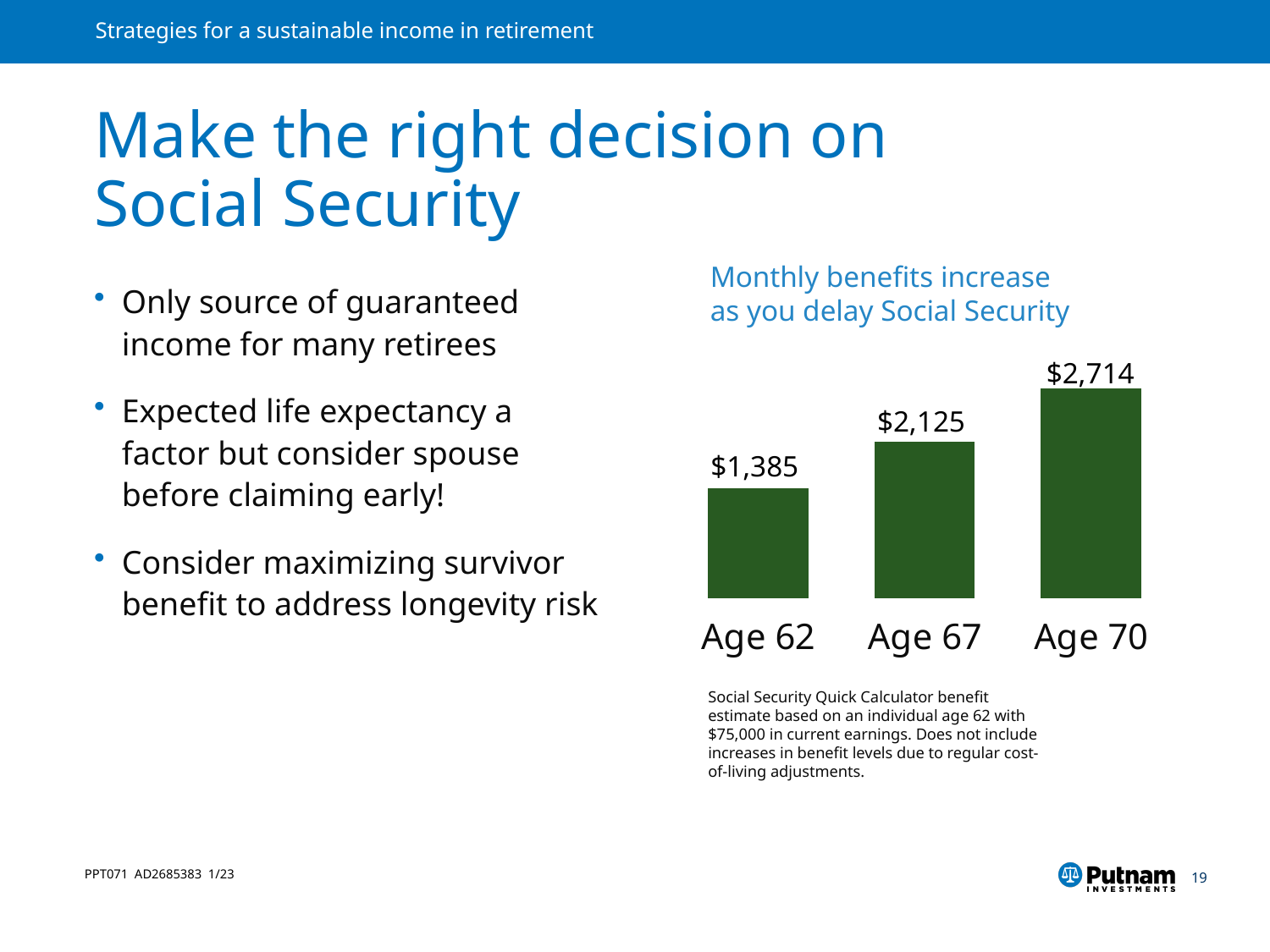
What kind of chart is shown on the slide? Bar chart Which age has the lowest monthly benefit? Age 62 What is the difference between the monthly benefit at Age 70 and at Age 62? $1,329 Which age has the highest monthly benefit? Age 70 What is the monthly benefit shown for Age 70? $2,714 How many age categories are shown in the chart? 3 What is the monthly benefit shown for Age 62? $1,385 Which is larger, the monthly benefit at Age 67 or at Age 70? Age 70 Do the monthly benefits rise or fall as age increases along the x axis? Rise What is the difference between the monthly benefit at Age 67 and at Age 62? $740 What is the monthly benefit shown for Age 67? $2,125 What is the title of the chart? Monthly benefits increase as you delay Social Security